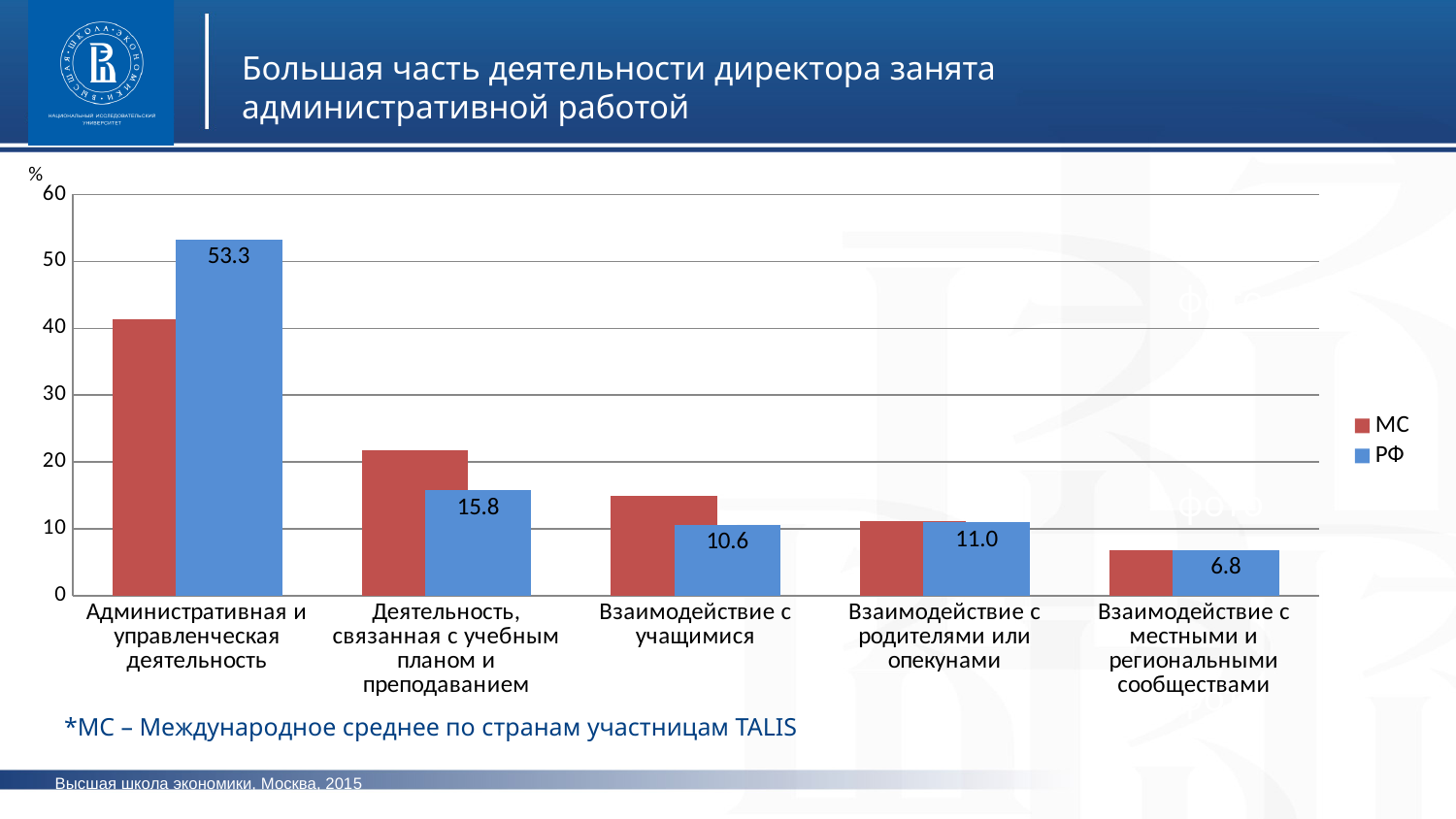
How many categories are shown on the x axis? 5 Is the МС value for «Взаимодействие с местными и региональными сообществами» greater or less than 10? less What is the РФ value for «Взаимодействие с местными и региональными сообществами»? 6.8 For «Деятельность, связанная с учебным планом и преподаванием», which series has the larger value, МС or РФ? МС What is the РФ value for «Административная и управленческая деятельность»? 53.3 What is the difference between the РФ values for «Административная и управленческая деятельность» and «Деятельность, связанная с учебным планом и преподаванием»? 37.5 What is the РФ value for «Взаимодействие с учащимися»? 10.6 Which category has the lowest РФ value? Взаимодействие с местными и региональными сообществами Which category has the highest РФ value? Административная и управленческая деятельность Is the МС value for «Административная и управленческая деятельность» greater or less than 30? greater How many series does the legend list? 2 For «Административная и управленческая деятельность», which series has the larger value, МС or РФ? РФ